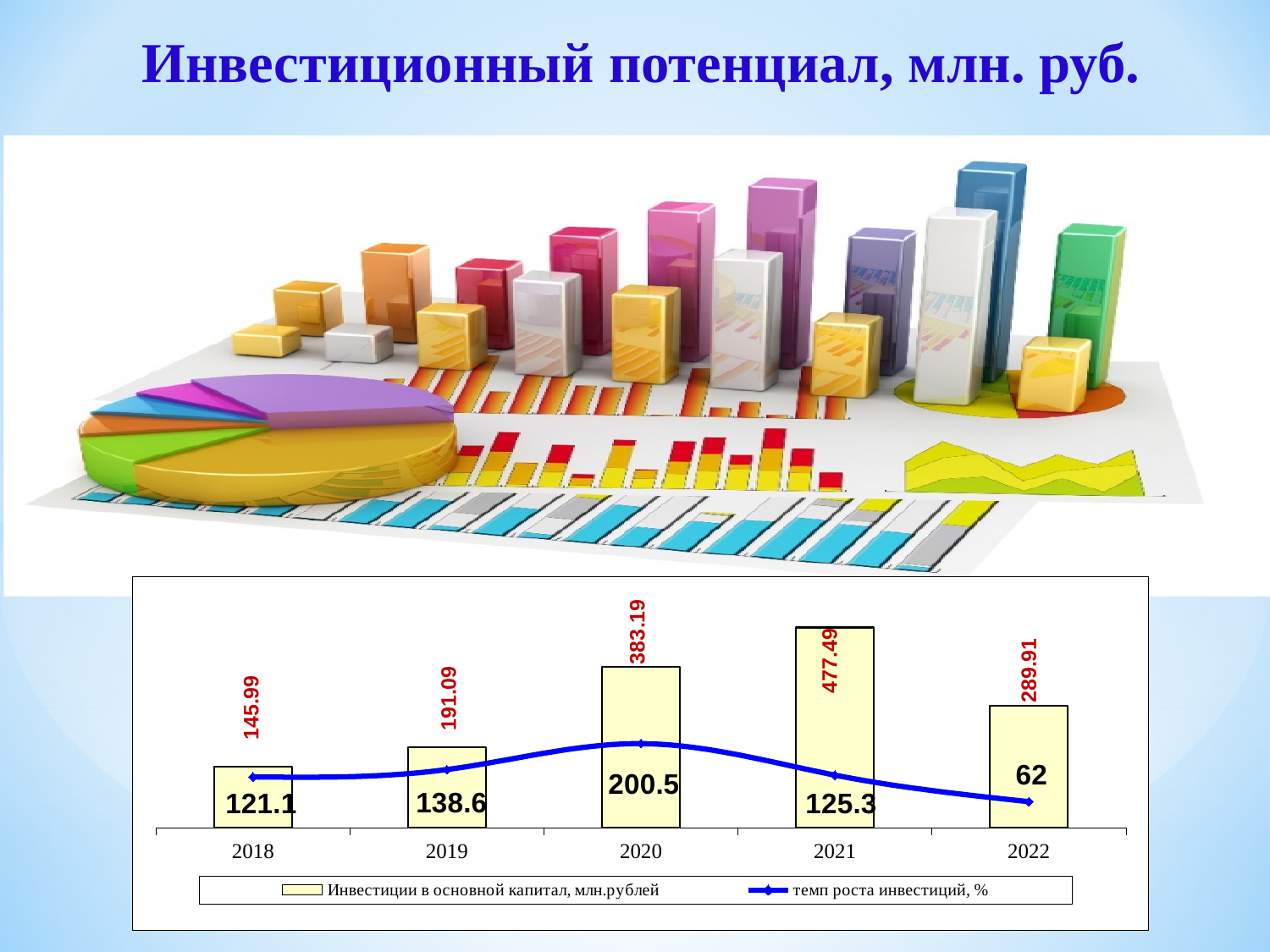
How many series does the chart legend list? 2 What is the difference between the investment growth rate in 2020 and 2019? 61.9 What kind of chart is used to show investments in fixed capital? bar chart How many years are shown on the x axis of the chart? 5 In which year is the investment growth rate (темп роста инвестиций, %) the lowest? 2022 What is the difference between investments in fixed capital in 2021 and 2020? 94.30 What is the value of investments in fixed capital for 2018? 145.99 Which year has a larger value of investments in fixed capital, 2019 or 2022? 2022 What is the investment growth rate (темп роста инвестиций, %) for 2022? 62 In which year are investments in fixed capital the highest? 2021 Do investments in fixed capital rise or fall from 2018 to 2021? rise What is the value of investments in fixed capital (Инвестиции в основной капитал) for 2020? 383.19